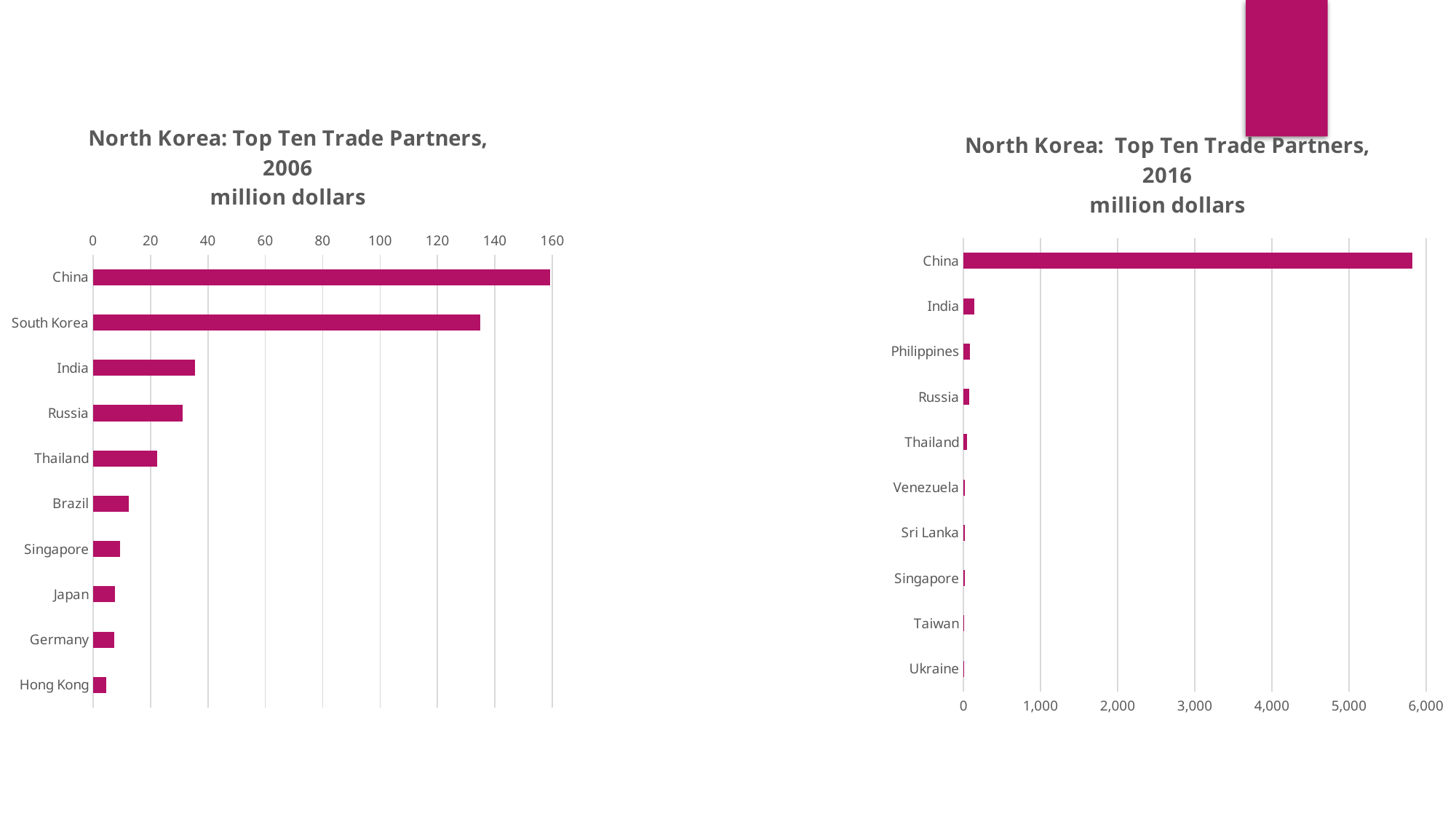
How many countries are shown in the 'North Korea: Top Ten Trade Partners, 2006' chart on the left? 10 In the 'North Korea: Top Ten Trade Partners, 2006' chart on the left, is the value for South Korea greater or less than 120? greater In the 'North Korea: Top Ten Trade Partners, 2016' chart on the right, is the value for China greater or less than 5,000? greater In the 'North Korea: Top Ten Trade Partners, 2016' chart on the right, which country has the highest value? China What kind of chart is the 'North Korea: Top Ten Trade Partners, 2006' chart on the left? bar chart In the 'North Korea: Top Ten Trade Partners, 2016' chart on the right, is the value for India greater or less than 1,000? less In the 'North Korea: Top Ten Trade Partners, 2006' chart on the left, which country has the highest value? China In the 'North Korea: Top Ten Trade Partners, 2006' chart on the left, which country has the lowest value? Hong Kong In the 'North Korea: Top Ten Trade Partners, 2016' chart on the right, what unit is stated in the chart title? million dollars In the 'North Korea: Top Ten Trade Partners, 2006' chart on the left, which is larger, the value for Thailand or the value for Brazil? Thailand How many countries are shown in the 'North Korea: Top Ten Trade Partners, 2016' chart on the right? 10